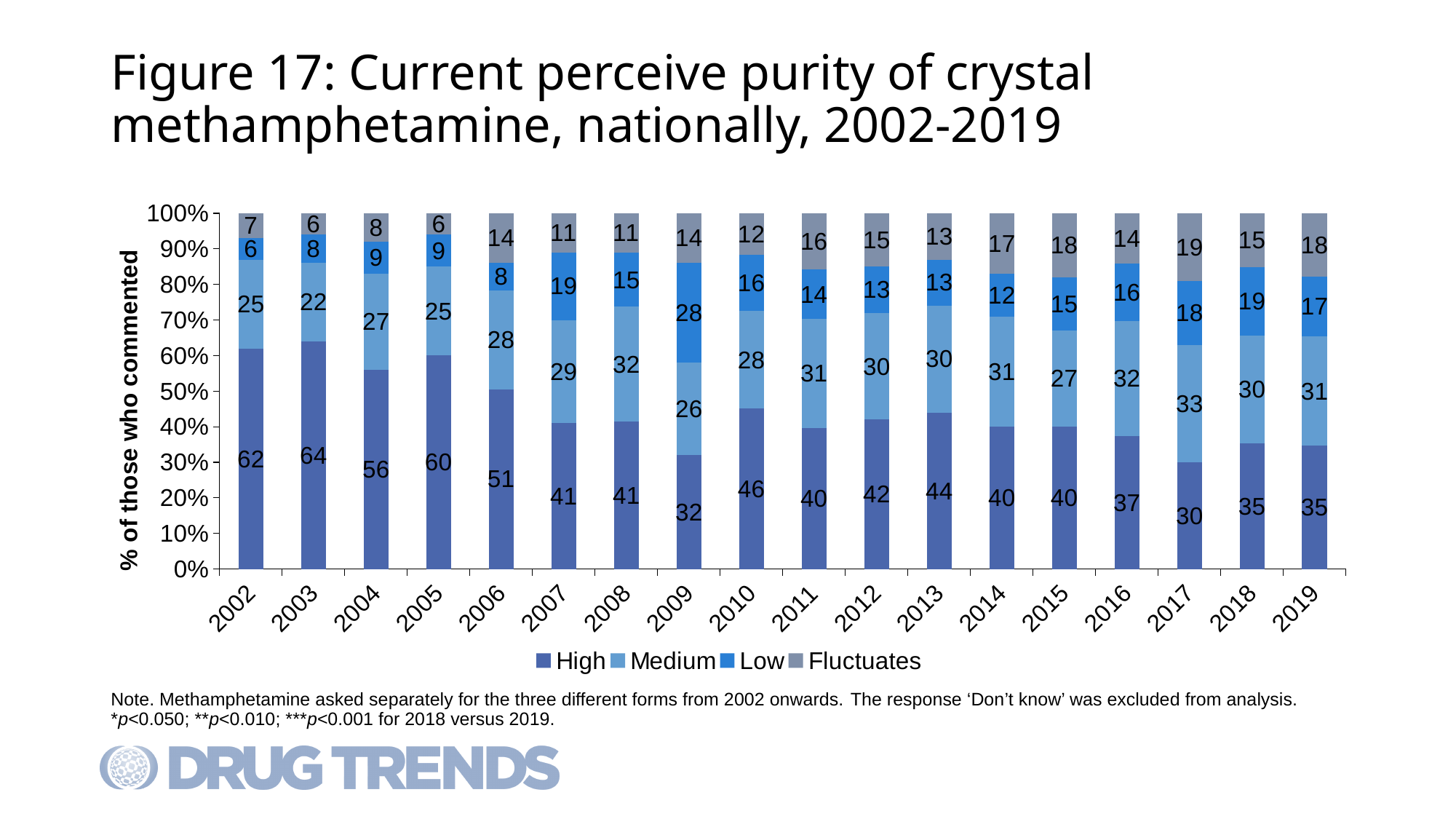
How many series does the legend list? 4 What is the value for Fluctuates in 2017? 19 In which year is the High value the lowest? 2017 What is the value for Medium in 2019? 31 What is the difference between the High value in 2002 and the High value in 2019? 27 Which is larger, the Medium value in 2017 or the Medium value in 2015? 2017 What kind of chart is shown on the slide? Stacked bar chart In which year is the High value the highest? 2003 What is the label of the y axis? % of those who commented How many years are shown on the x axis? 18 What is the value for Low in 2009? 28 What is the value for High in 2003? 64